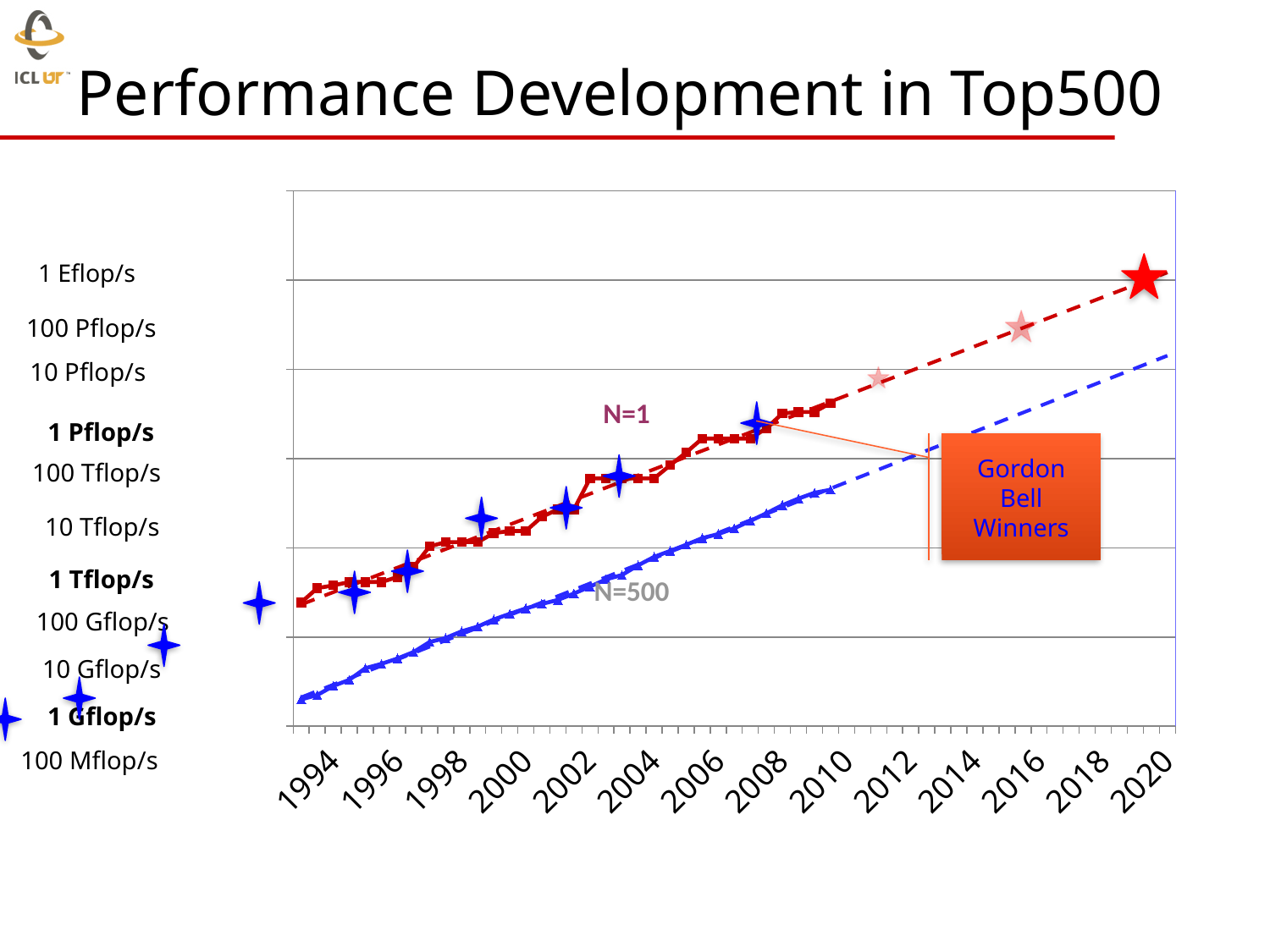
Does the N=500 series rise or fall from 1994 to 2010? rise What is the first year and the last year labelled on the x axis? 1994 and 2020 How many data series are plotted in the chart? 2 Is the value of the N=500 series in 2010 greater or less than 100 Tflop/s? less What are the names of the two series plotted in the chart? N=1 and N=500 Is the value of the N=1 series in 2008 greater or less than 100 Tflop/s? greater Is the value of the N=500 series in 1994 greater or less than 10 Gflop/s? less What is the highest performance level labelled on the y axis? 1 Eflop/s What performance level does the dashed N=1 projection reach at 2020, marked by the large red star? 1 Eflop/s What kind of chart is shown on the slide? line chart Which series has the higher value in 2008, N=1 or N=500? N=1